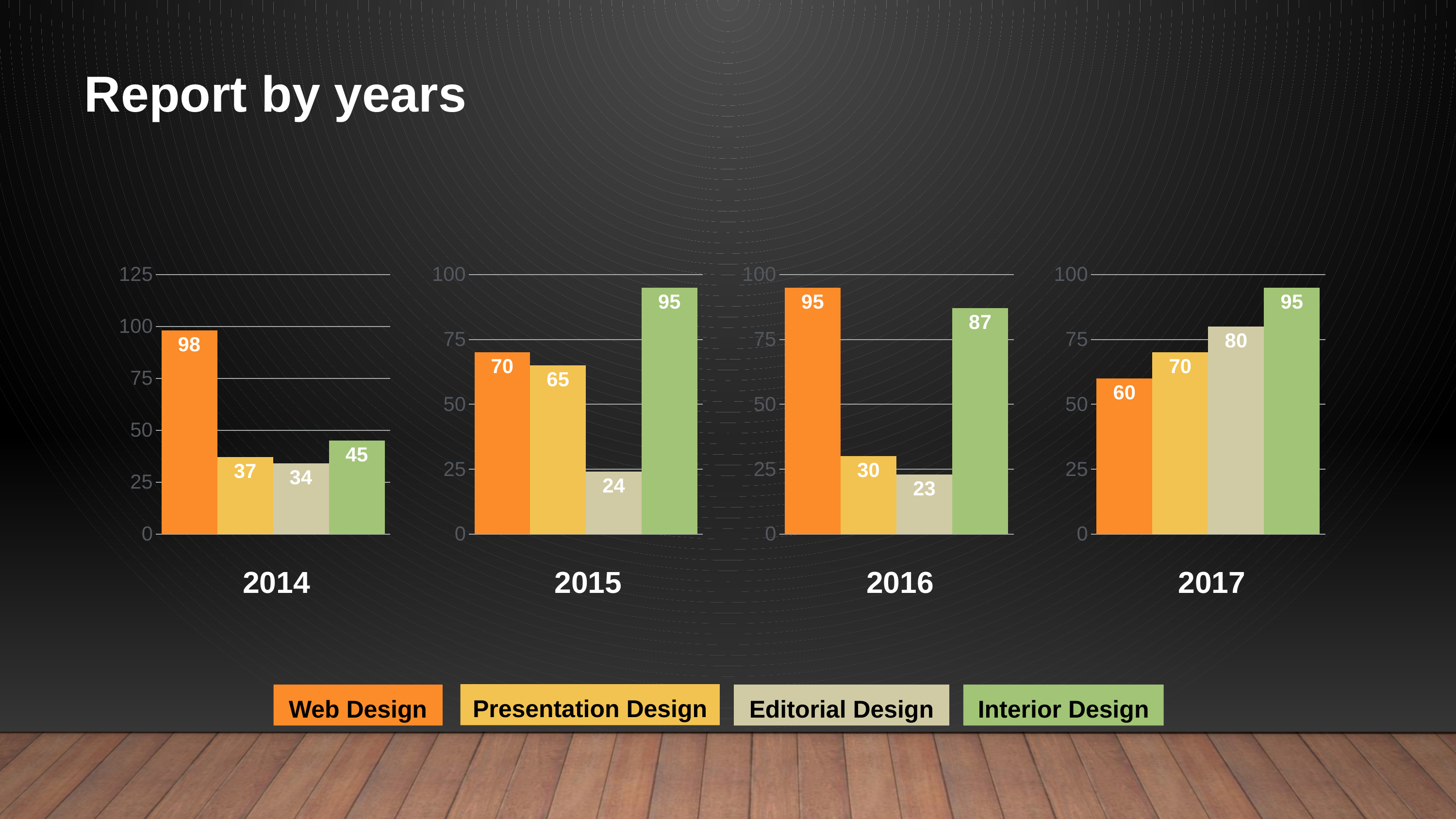
In the 2014 chart, what is the value for Web Design? 98 In the 2017 chart, do the values rise or fall from Web Design to Interior Design? rise How many bars are shown in the 2016 chart? 4 In the 2014 chart, which is larger, the value for Presentation Design or the value for Interior Design? Interior Design How many series does the legend at the bottom of the slide list? 4 In the 2017 chart, which series has the highest value? Interior Design In the 2016 chart, what is the difference between the Web Design value and the Interior Design value? 8 In the 2015 chart, which series has the lowest value? Editorial Design In the 2017 chart, is the value for Editorial Design greater or less than 75? greater In the 2015 chart, what is the value for Interior Design? 95 What kind of chart is the 2015 chart? bar chart In the 2016 chart, what is the value for Editorial Design? 23